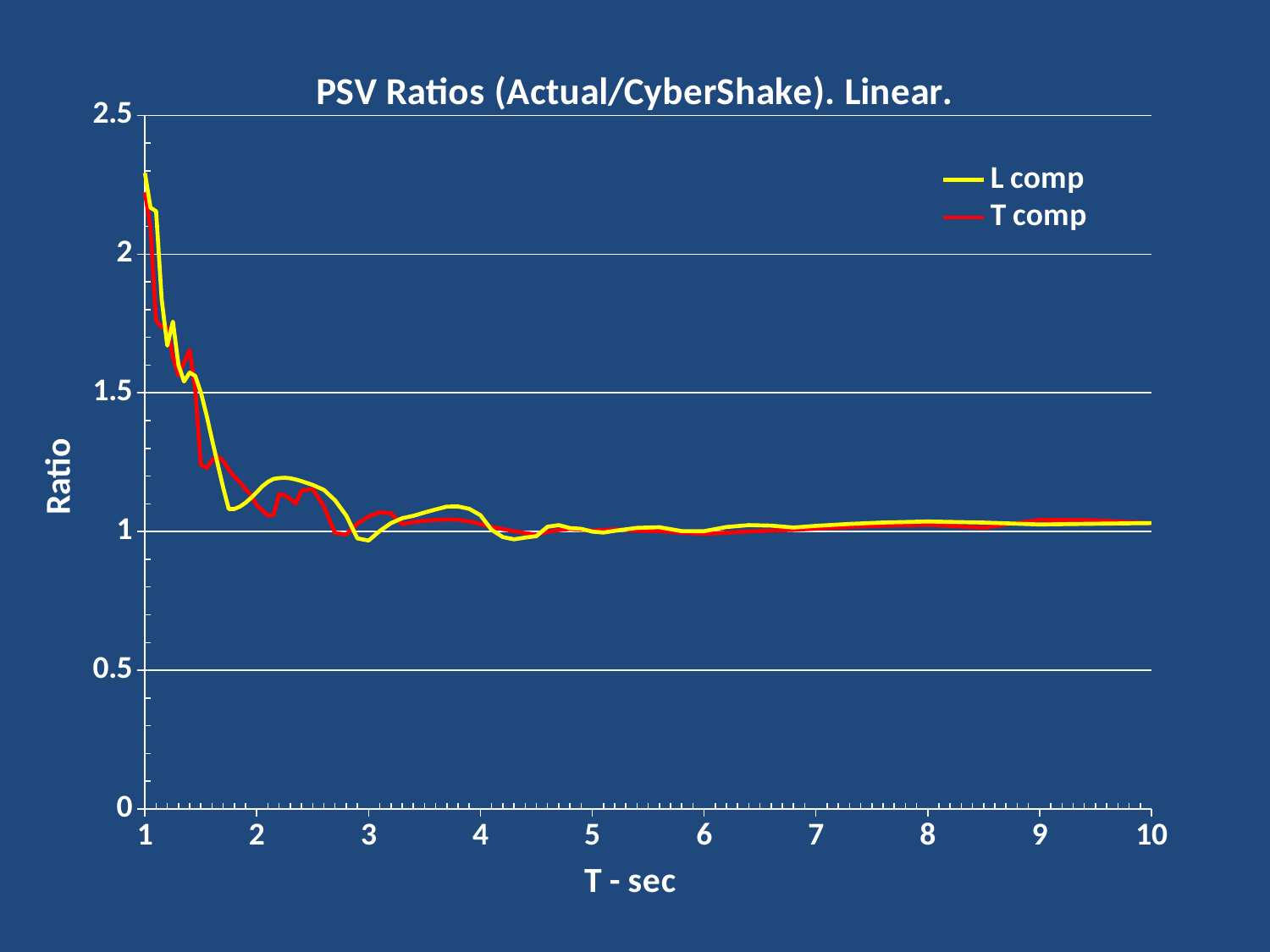
Is the value of L comp at T = 1 sec greater or less than 2.5? less How many labelled tick values are shown on the x axis? 10 Is the value of L comp at T = 1 sec greater or less than 2? greater What is the title of the chart? PSV Ratios (Actual/CyberShake). Linear. Is the value of L comp at T = 5 sec greater or less than 1.5? less What kind of chart is shown on the slide? line chart Do the ratio values rise or fall as T increases from 1 to 10 sec? fall Which colour is used for the L comp series? yellow How many series does the legend list? 2